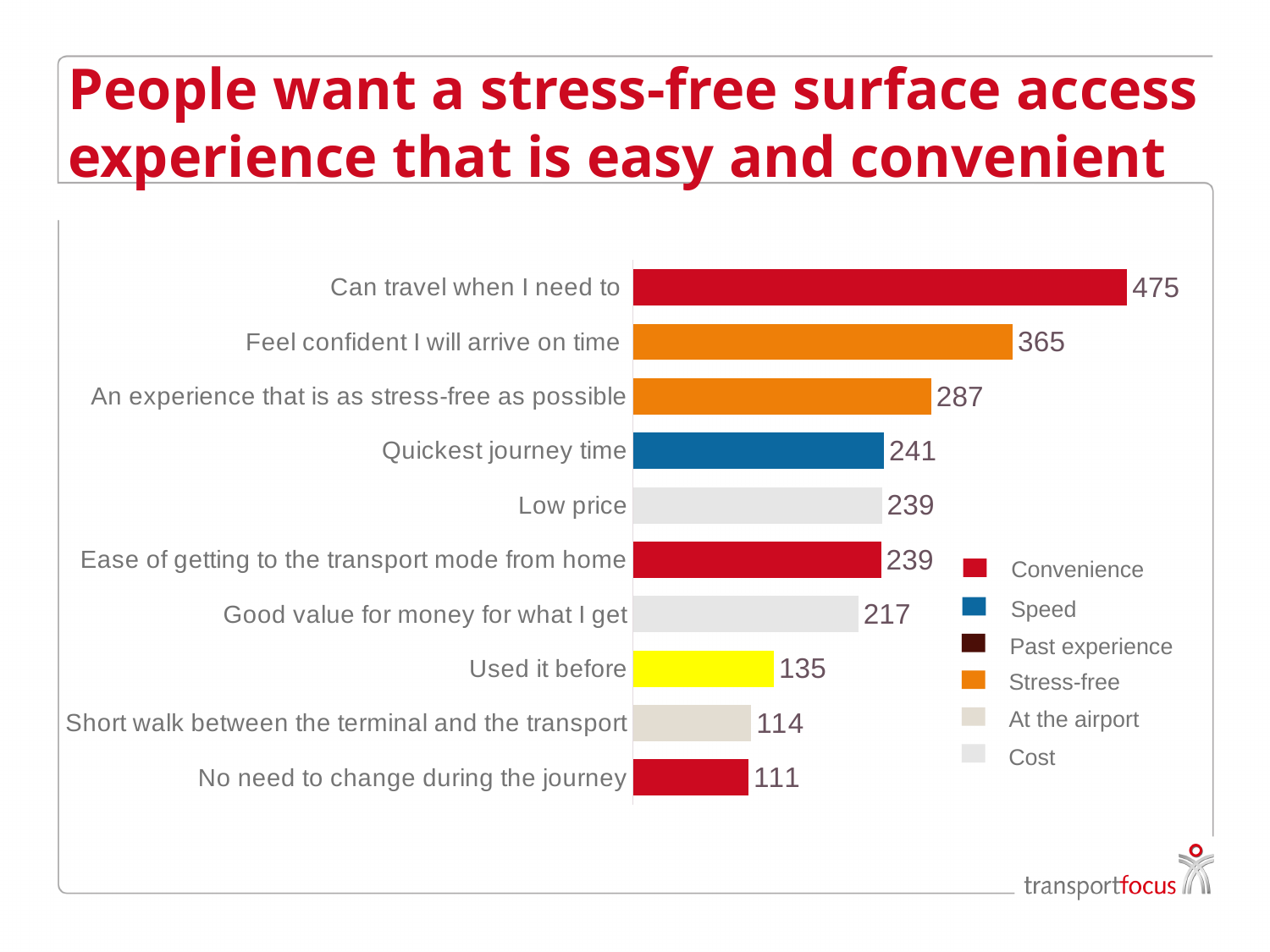
What is the value for "Used it before"? 135 What is the value for "Short walk between the terminal and the transport"? 114 How many categories are shown in the chart? 10 Which category has the lowest value? No need to change during the journey What is the difference between the values for "An experience that is as stress-free as possible" and "Quickest journey time"? 46 Which is larger, the value for "Good value for money for what I get" or the value for "Used it before"? Good value for money for what I get What is the difference between the values for "Can travel when I need to" and "Feel confident I will arrive on time"? 110 What kind of chart is shown on the slide? Bar chart How many entries does the legend list? 6 What is the value for "Can travel when I need to"? 475 Which legend entry is shown in orange? Stress-free Which category has the highest value? Can travel when I need to